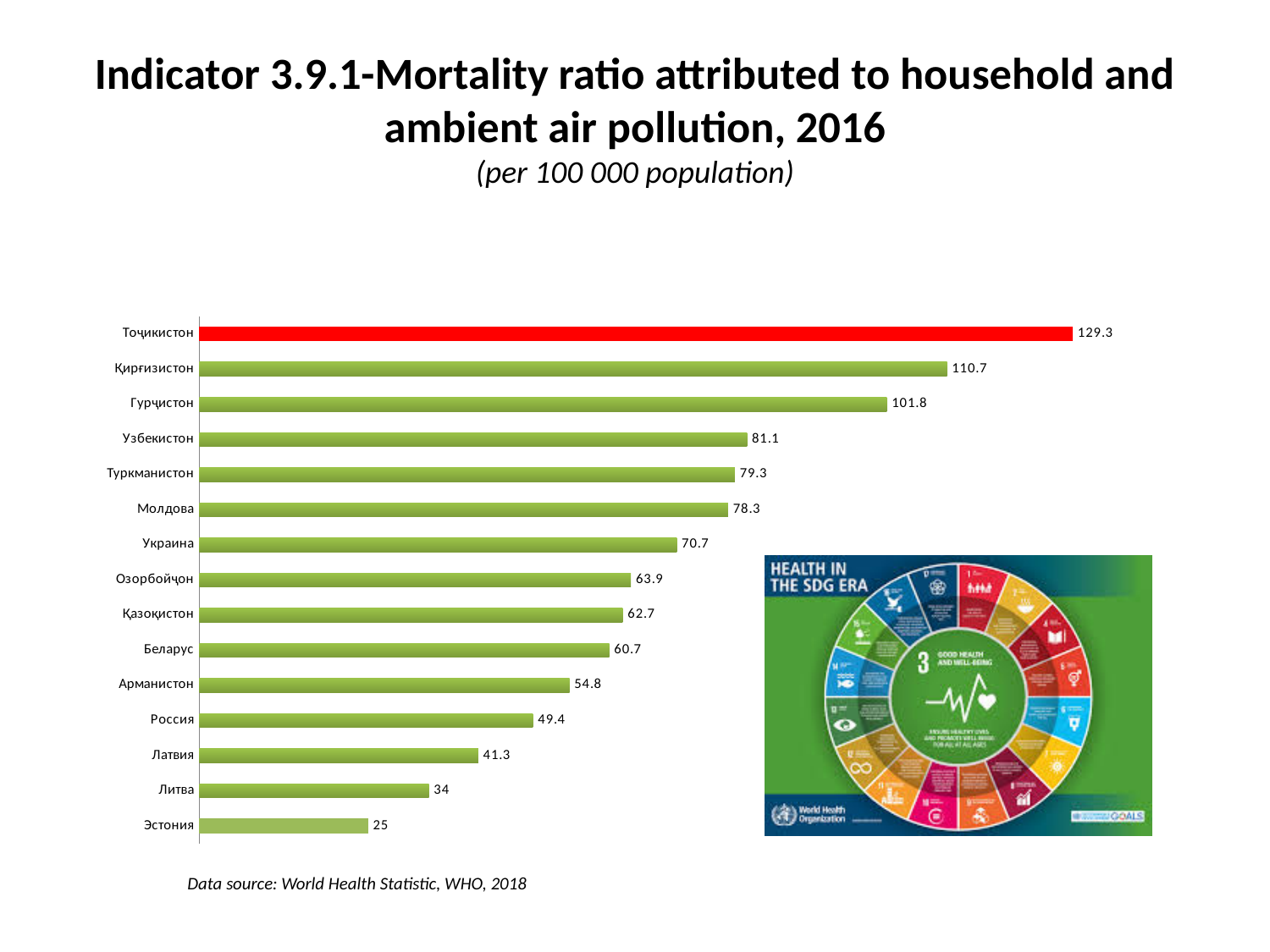
What is the value for Тоҷикистон? 129.3 What data source is cited below the chart? World Health Statistic, WHO, 2018 What is the value for Латвия? 41.3 What is the value for Молдова? 78.3 Which bar is coloured red rather than green? Тоҷикистон Which is larger, the value for Узбекистон or the value for Украина? Узбекистон What is the difference between the values for Литва and Эстония? 9 What kind of chart is shown on the slide? bar chart How many countries are shown on the chart? 15 What is the difference between the values for Тоҷикистон and Қирғизистон? 18.6 Which country has the highest mortality ratio on the chart? Тоҷикистон Which country has the lowest mortality ratio on the chart? Эстония